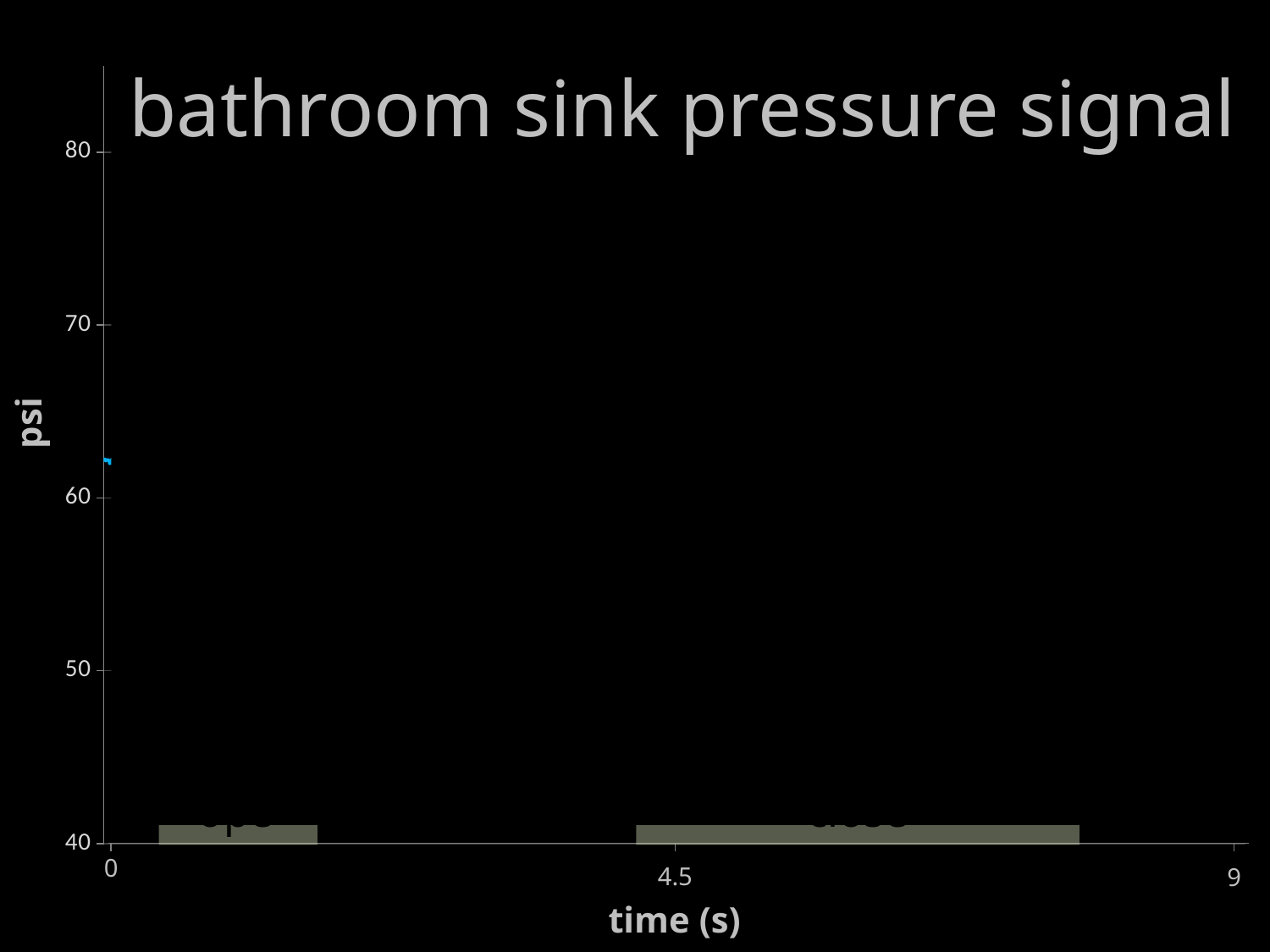
What are the axis titles of the chart? psi (y axis) and time (s) (x axis) Is the plotted pressure value at time 0 greater or less than 70 psi? less Is the plotted pressure value at time 0 greater or less than 60 psi? greater What is the title of the chart? bathroom sink pressure signal